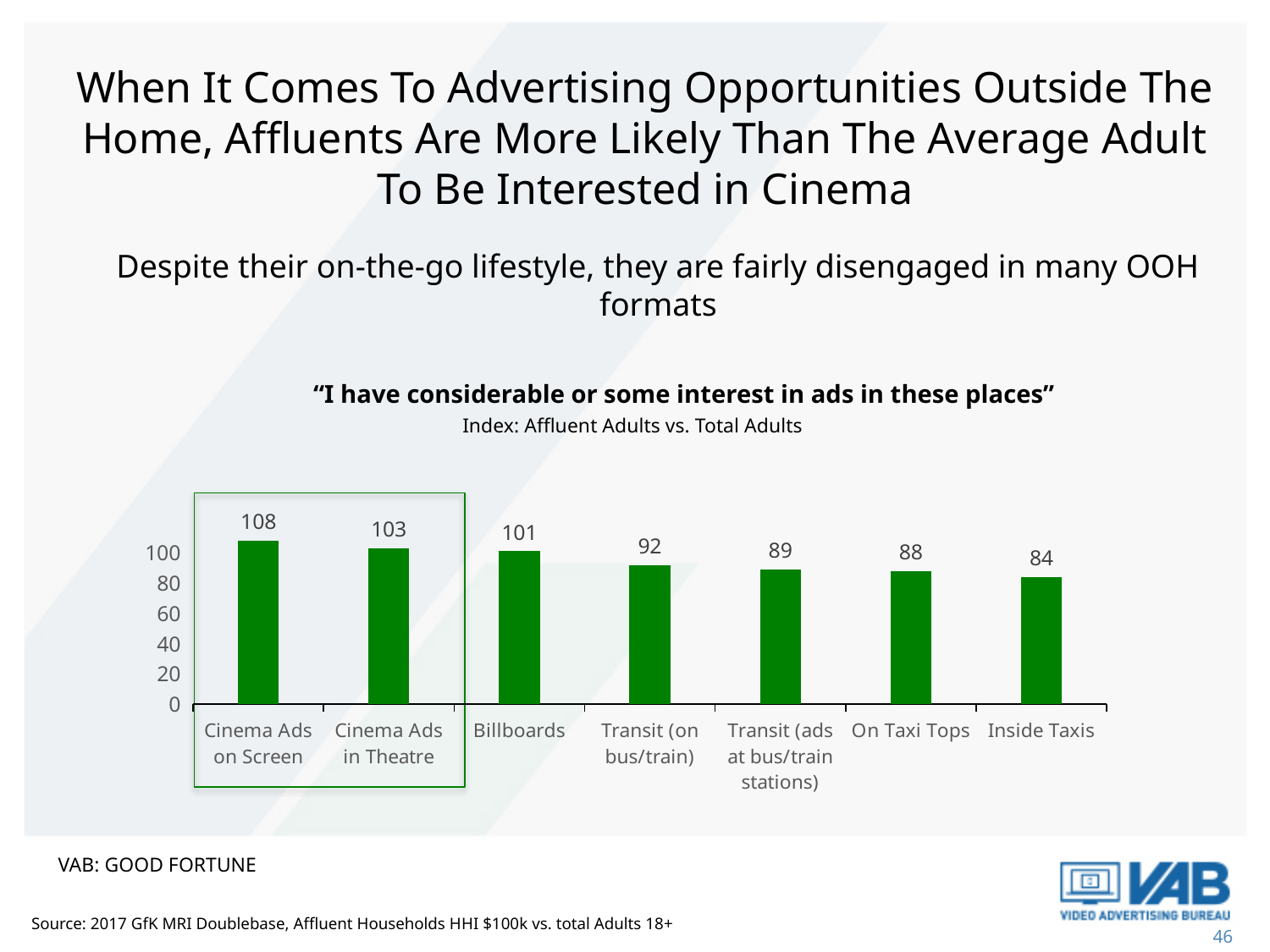
Is the index value for Transit (on bus/train) greater or less than 100? less Which category has the lowest index value? Inside Taxis Do the index values rise or fall from left to right across the categories? fall What kind of chart is shown on the slide? bar chart Which has a higher index value, Cinema Ads in Theatre or On Taxi Tops? Cinema Ads in Theatre Which category has the highest index value? Cinema Ads on Screen What is the index value for Transit (ads at bus/train stations)? 89 What is the difference between the index values for Cinema Ads on Screen and Inside Taxis? 24 How many categories are shown in the chart? 7 What is the difference between the index values for Billboards and Transit (on bus/train)? 9 What is the index value for Inside Taxis? 84 What is the index value for Cinema Ads on Screen? 108